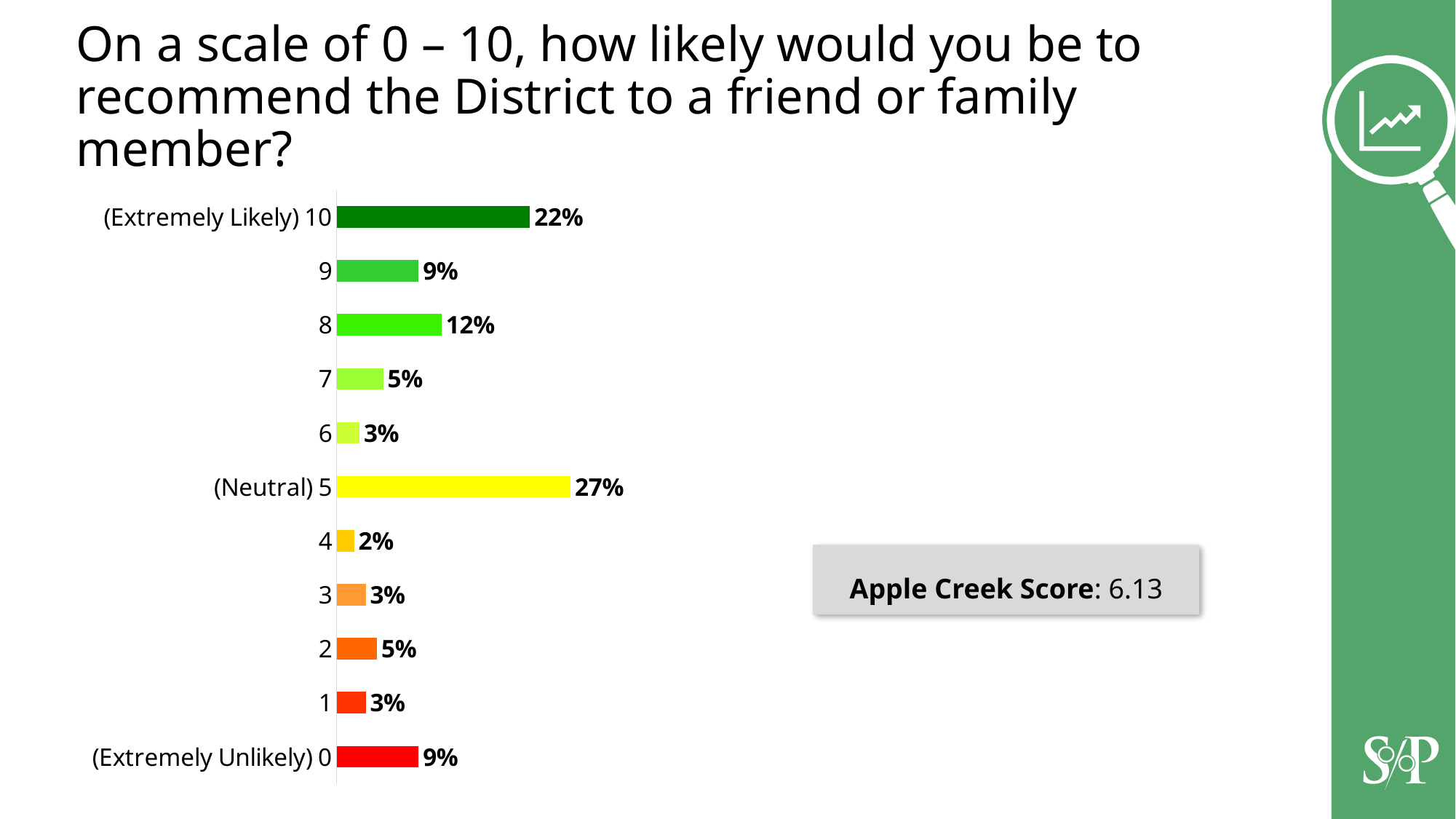
Which rating has the lowest percentage of respondents? 4 What percentage of respondents gave a rating of 10 (Extremely Likely)? 22% Which has a larger percentage: rating 9 or rating 8? Rating 8 What colour is the bar for rating 5 (Neutral)? Yellow What percentage of respondents gave a rating of 8? 12% What is the Apple Creek Score shown on the slide? 6.13 What kind of chart is shown on the slide? Bar chart How many rating categories are shown in the chart? 11 Which rating has the highest percentage of respondents? 5 (Neutral) What percentage of respondents gave a rating of 0 (Extremely Unlikely)? 9% What is the difference between the percentage for rating 5 and the percentage for rating 10? 5% What percentage of respondents gave a rating of 5 (Neutral)? 27%